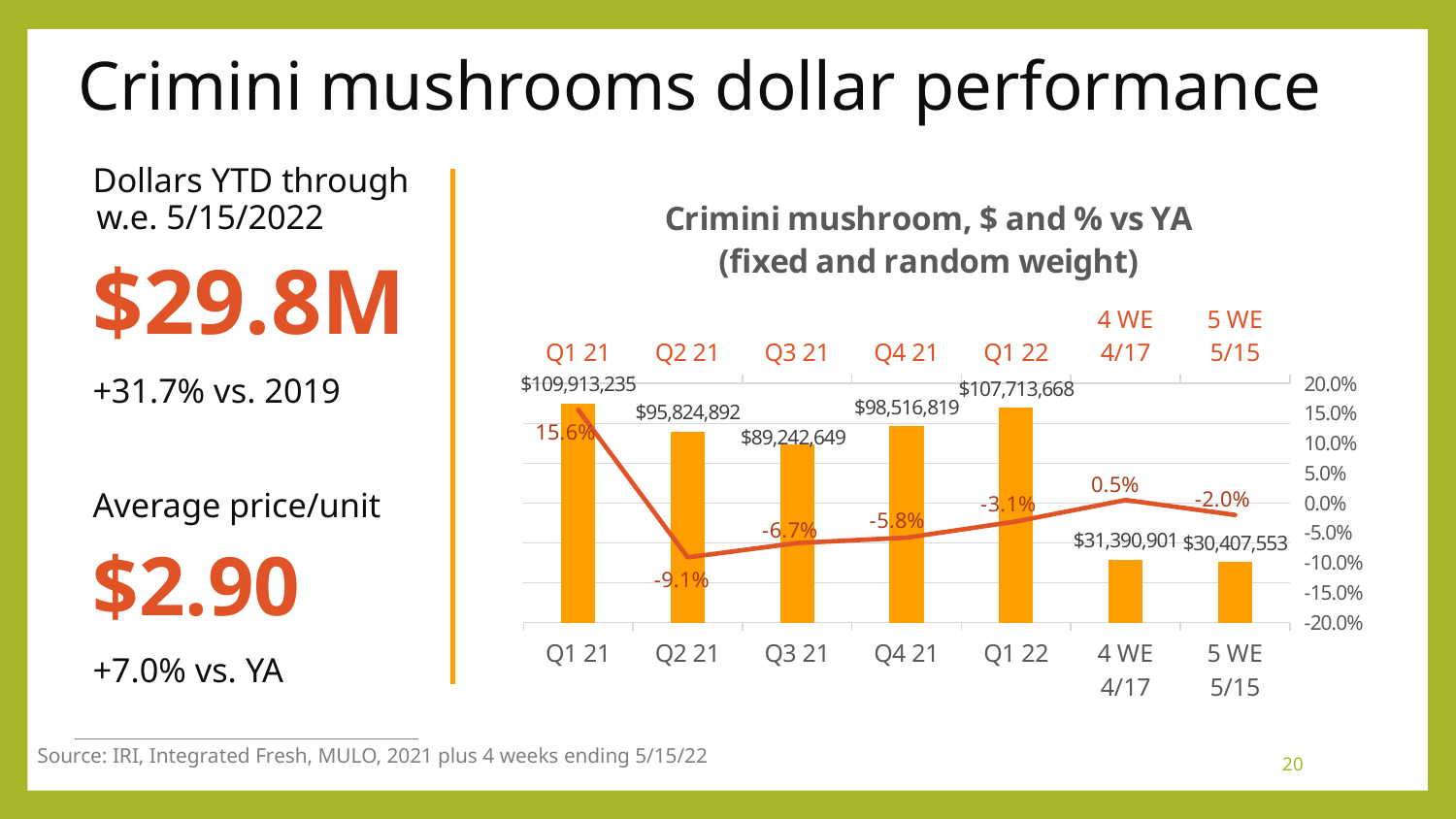
Which period has the lowest % vs YA? Q2 21 Which period has the highest dollar value? Q1 21 What is the title of the chart? Crimini mushroom, $ and % vs YA (fixed and random weight) What is the dollar value shown for Q1 21? $109,913,235 What is the % vs YA shown for Q2 21? -9.1% What is the difference in dollar value between Q1 21 and Q2 21? $14,088,343 How many periods are shown on the x axis of the chart? 7 What is the % vs YA shown for the 4 WE 4/17 period? 0.5% What is the difference in dollar value between Q1 22 and Q4 21? $9,196,849 What kind of chart is shown on the slide? Combined bar and line chart Which has the larger dollar value, Q3 21 or Q4 21? Q4 21 What is the dollar value shown for the 5 WE 5/15 period? $30,407,553